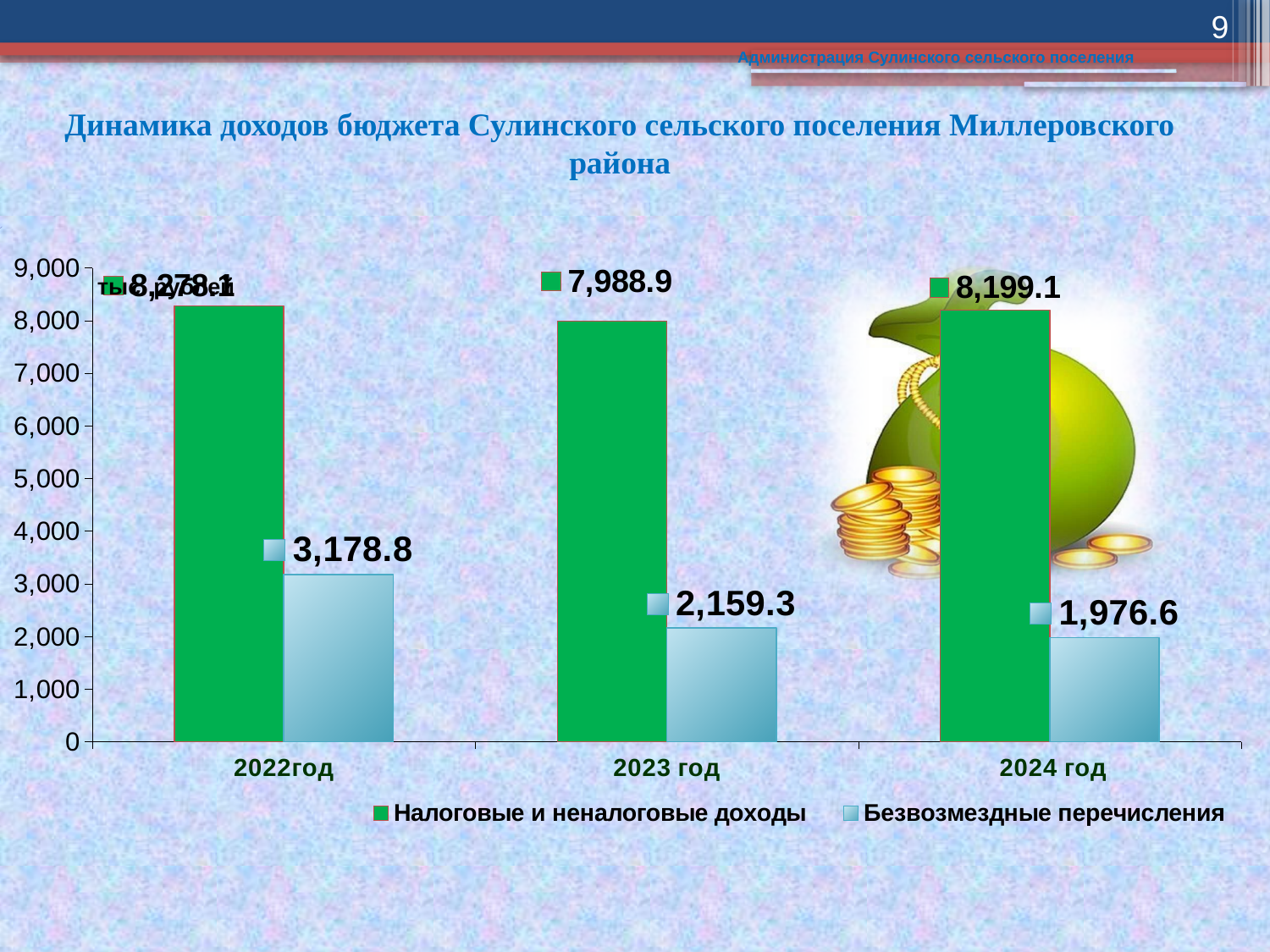
In which year is Безвозмездные перечисления the highest? 2022год In which year is Безвозмездные перечисления the lowest? 2024 год What is the difference between Налоговые и неналоговые доходы and Безвозмездные перечисления in 2023 год? 5,829.6 What is the value of Безвозмездные перечисления for 2022год? 3,178.8 What is the value of Налоговые и неналоговые доходы for 2023 год? 7,988.9 What is the value of Безвозмездные перечисления for 2024 год? 1,976.6 Is the value of Налоговые и неналоговые доходы for 2022год greater or less than 8,000? greater Which year has the larger value of Налоговые и неналоговые доходы, 2023 год or 2024 год? 2024 год How many series does the legend list? 2 By how much does Безвозмездные перечисления in 2022год exceed that in 2024 год? 1,202.2 What is the value of Налоговые и неналоговые доходы for 2024 год? 8,199.1 Does Безвозмездные перечисления rise or fall from 2022год to 2024 год? fall